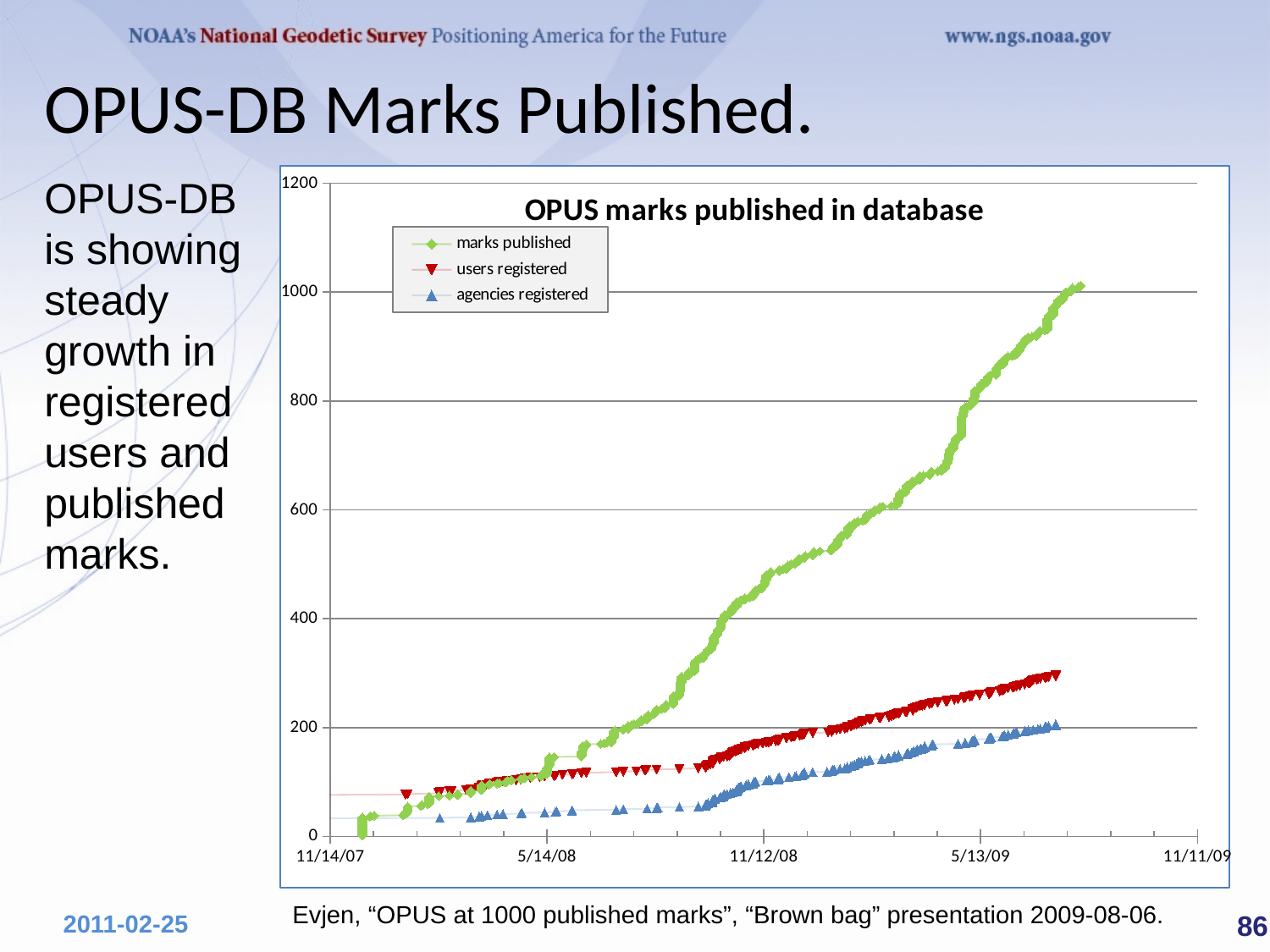
Do the values for marks published rise or fall over time along the x axis? rise Is the final value for users registered greater or less than 400? less Do the values for users registered rise or fall over time along the x axis? rise What is the title of the chart? OPUS marks published in database Which series has the lowest values on the chart? agencies registered How many series does the chart legend list? 3 Which series is drawn in green? marks published What kind of chart is shown on the slide? line chart Which series reaches the highest value on the chart? marks published At the end of the plotted period, which is larger: marks published or users registered? marks published Is the final value for marks published greater or less than 800? greater Is the final value for agencies registered greater or less than 400? less